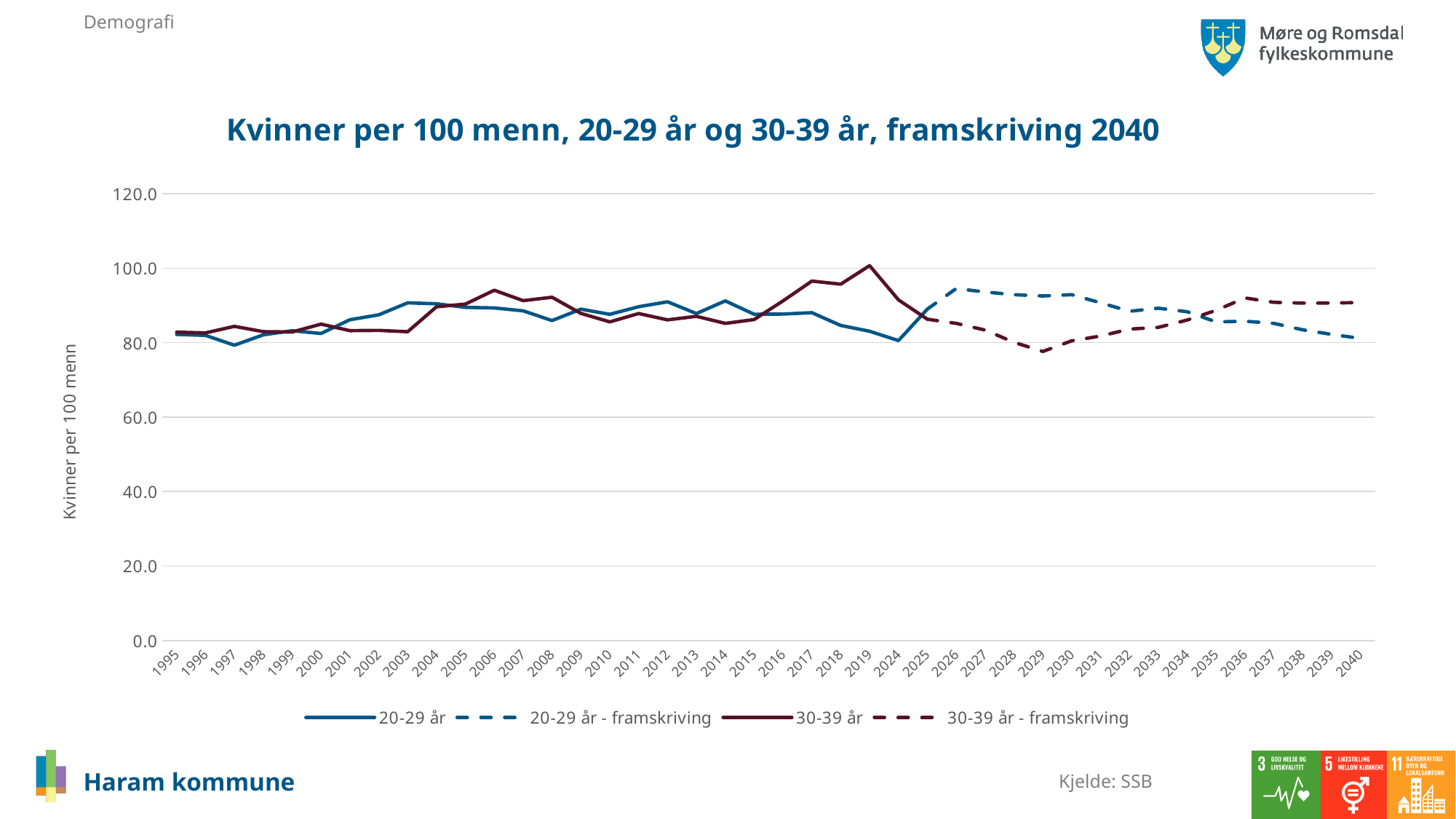
Is the value for 30-39 år - framskriving in 2029 greater or less than 80? less In which year does the 30-39 år line reach its highest value? 2019 In 2019, which series has the higher value: 20-29 år or 30-39 år? 30-39 år What is the label on the vertical axis? Kvinner per 100 menn Is the value for 30-39 år in 2017 greater or less than 100? less Does the 20-29 år - framskriving line generally rise or fall from 2026 to 2040? fall In 2029, which projection is higher: 20-29 år - framskriving or 30-39 år - framskriving? 20-29 år - framskriving Does the 30-39 år line rise or fall from 2015 to 2019? rise How many series does the legend list? 4 What is the title of the chart? Kvinner per 100 menn, 20-29 år og 30-39 år, framskriving 2040 What kind of chart is shown on the slide? Line chart Is the value for 20-29 år - framskriving in 2026 greater or less than 80? greater